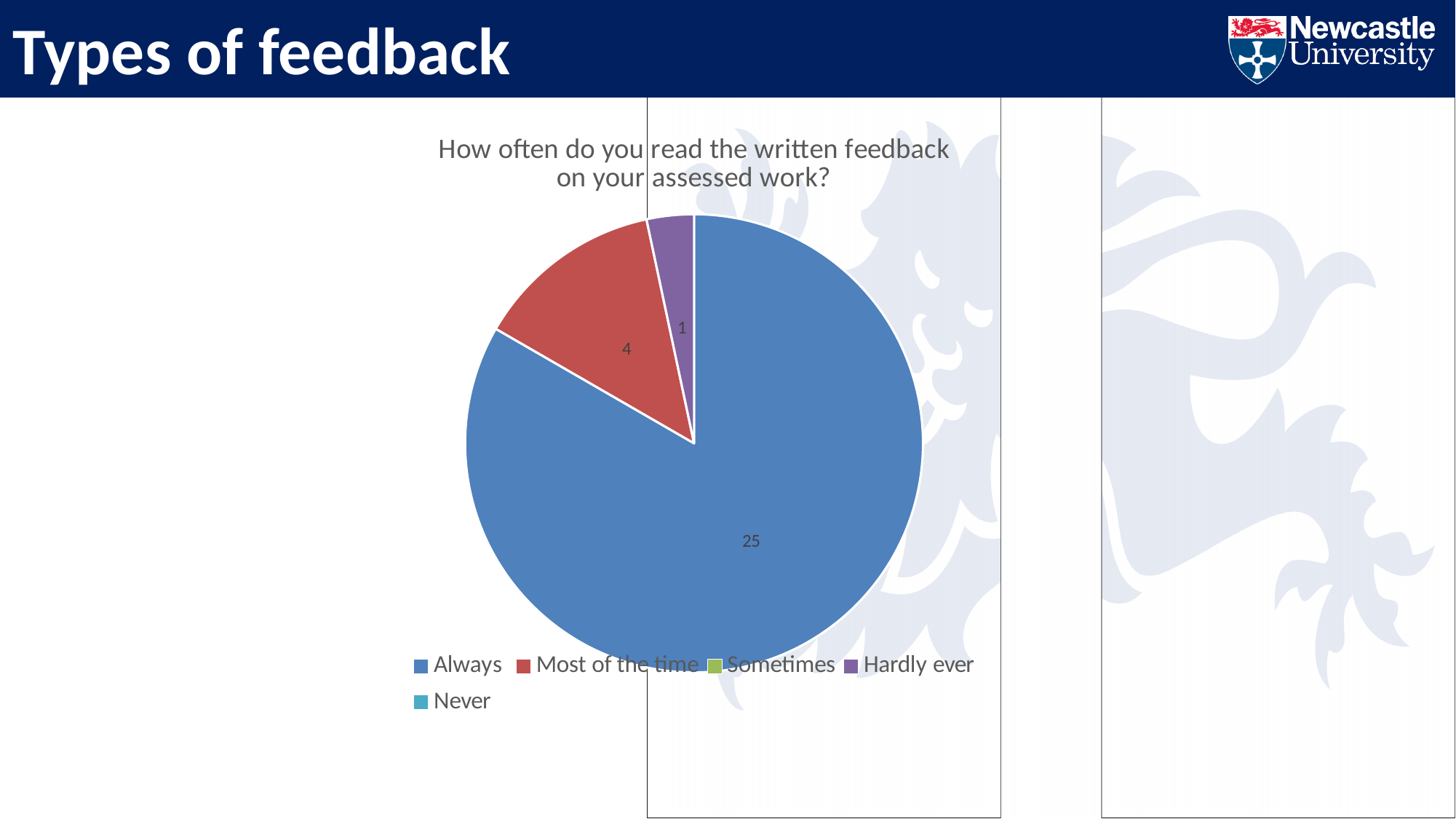
What value is shown for the 'Most of the time' slice? 4 What value is shown for the 'Always' slice? 25 What is the difference between the 'Most of the time' value and the 'Hardly ever' value? 3 What is the difference between the 'Always' value and the 'Most of the time' value? 21 What is the title of the chart? How often do you read the written feedback on your assessed work? What is the total of the three labelled slice values (25, 4 and 1)? 30 What kind of chart is shown on the slide? pie chart Which is larger, the 'Most of the time' slice or the 'Hardly ever' slice? Most of the time How many categories does the legend list? 5 Which category has the largest slice of the pie? Always Of the slices that carry a value label, which is the smallest? Hardly ever What value is shown for the 'Hardly ever' slice? 1